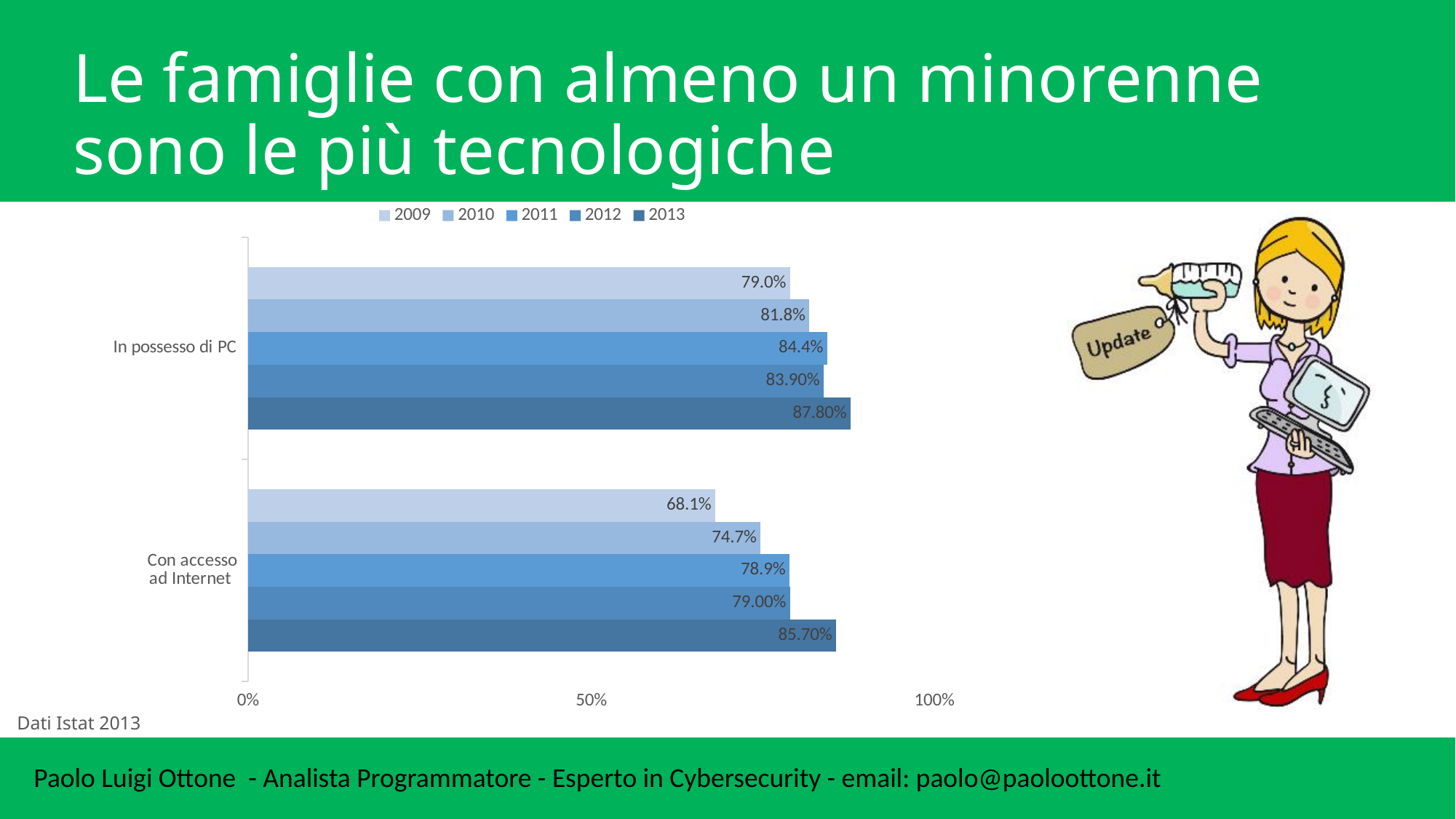
What is the value for 2009 in the 'Con accesso ad Internet' category? 68.1% Which year has the highest value in the 'Con accesso ad Internet' category? 2013 Is the 2010 value for 'Con accesso ad Internet' greater or less than 50%? greater How many categories are shown on the chart? 2 What is the value for 2013 in the 'In possesso di PC' category? 87.80% What is the value for 2011 in the 'In possesso di PC' category? 84.4% Which is larger: the 2012 value for 'In possesso di PC' or the 2012 value for 'Con accesso ad Internet'? In possesso di PC What is the difference between the 2013 and 2009 values in the 'Con accesso ad Internet' category? 17.6% How many series does the legend list? 5 What kind of chart is shown on the slide? bar chart Which year has the lowest value in the 'In possesso di PC' category? 2009 What data source is cited below the chart? Dati Istat 2013